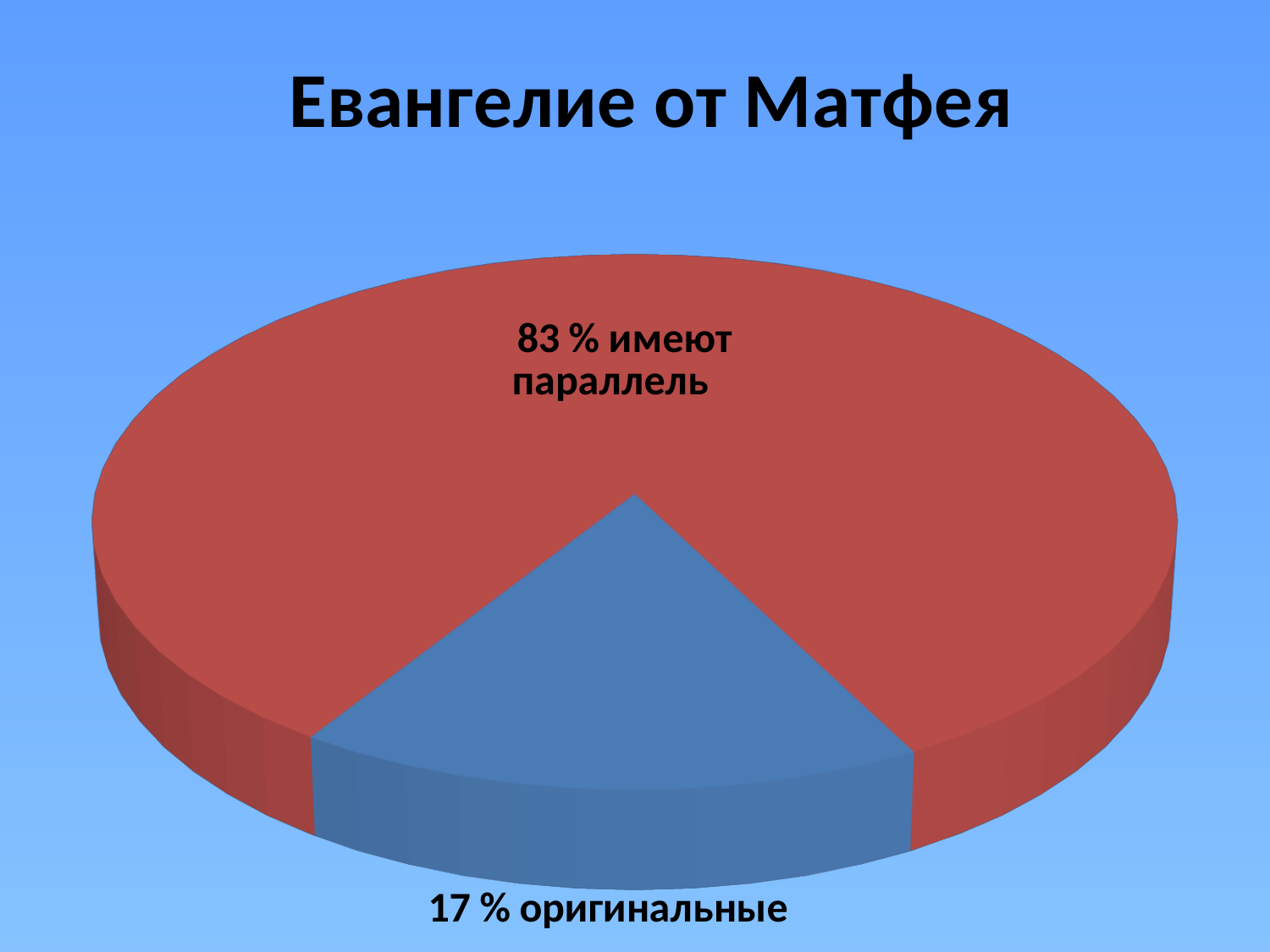
What kind of chart is shown on the slide? pie chart How many slices does the pie chart have? 2 Which slice is the smallest? оригинальные What percentage of the pie is labelled "оригинальные"? 17 % What is the title of the chart? Евангелие от Матфея Which is larger, the "имеют параллель" slice or the "оригинальные" slice? имеют параллель What colour is the "оригинальные" slice? blue What percentage of the pie is labelled "имеют параллель"? 83 % What is the difference in percentage points between the "имеют параллель" slice and the "оригинальные" slice? 66 Which slice is the largest? имеют параллель What share of the pie does the "имеют параллель" slice take? 83 %